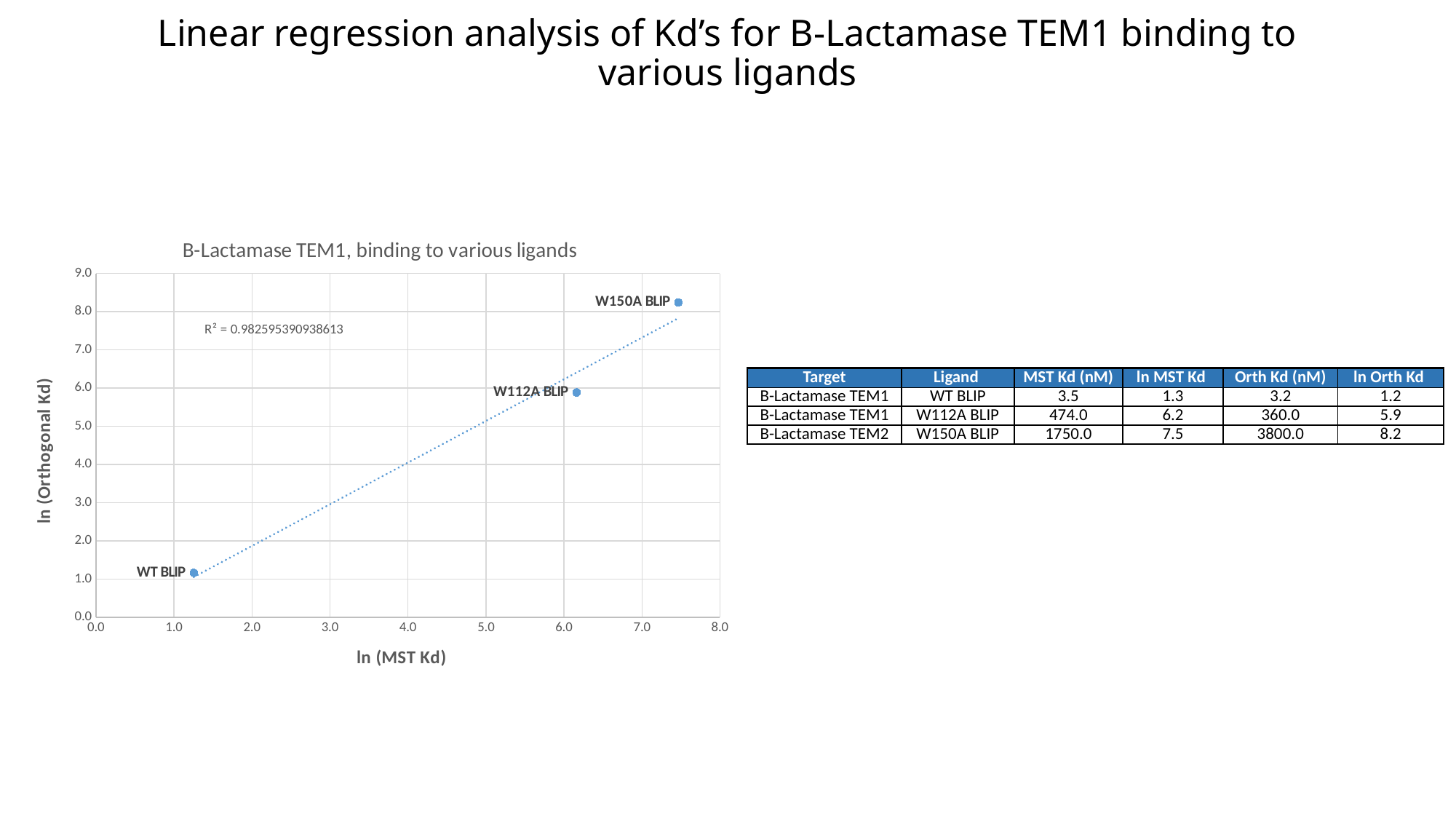
What is the title of the chart? B-Lactamase TEM1, binding to various ligands Which point has a larger ln (Orthogonal Kd) value, W150A BLIP or W112A BLIP? W150A BLIP What R² value is shown on the chart? 0.982595390938613 Which ligand has the lowest ln (Orthogonal Kd) value on the chart? WT BLIP Is the ln (Orthogonal Kd) value for WT BLIP greater or less than 2.0? less Which ligand has the highest ln (Orthogonal Kd) value on the chart? W150A BLIP What kind of chart is shown on the slide? scatter chart How many data points are plotted on the chart? 3 Is the ln (Orthogonal Kd) value for W150A BLIP greater or less than 7.0? greater Is the ln (MST Kd) value for W112A BLIP greater or less than 5.0? greater Do the plotted values rise or fall as ln (MST Kd) increases along the x axis? rise